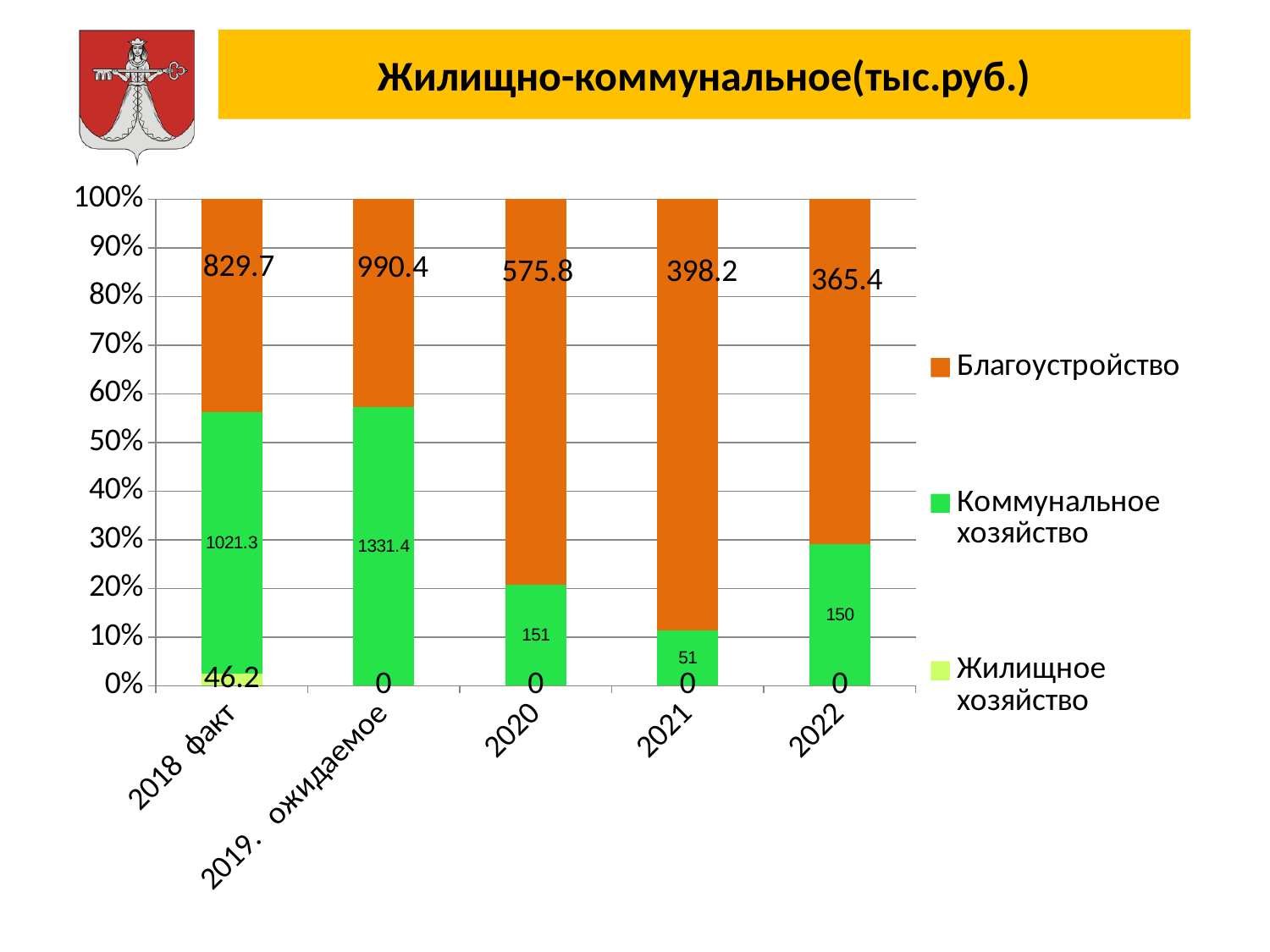
Which is larger: Коммунальное хозяйство in 2020 or in 2022? 2020 Is the share of Коммунальное хозяйство in the 2018 факт bar greater or less than 50%? greater What is the value for Коммунальное хозяйство in 2019. ожидаемое? 1331.4 What is the value for Благоустройство in 2020? 575.8 What kind of chart is shown on the slide? stacked bar chart How many series does the legend list? 3 What is the total of the 2021 bar? 449.2 Which category has the lowest value for Коммунальное хозяйство? 2021 What is the difference between the Благоустройство values for 2018 факт and 2022? 464.3 What is the value for Жилищное хозяйство in 2018 факт? 46.2 Which category has the highest value for Благоустройство? 2019. ожидаемое How many categories are shown on the x axis? 5